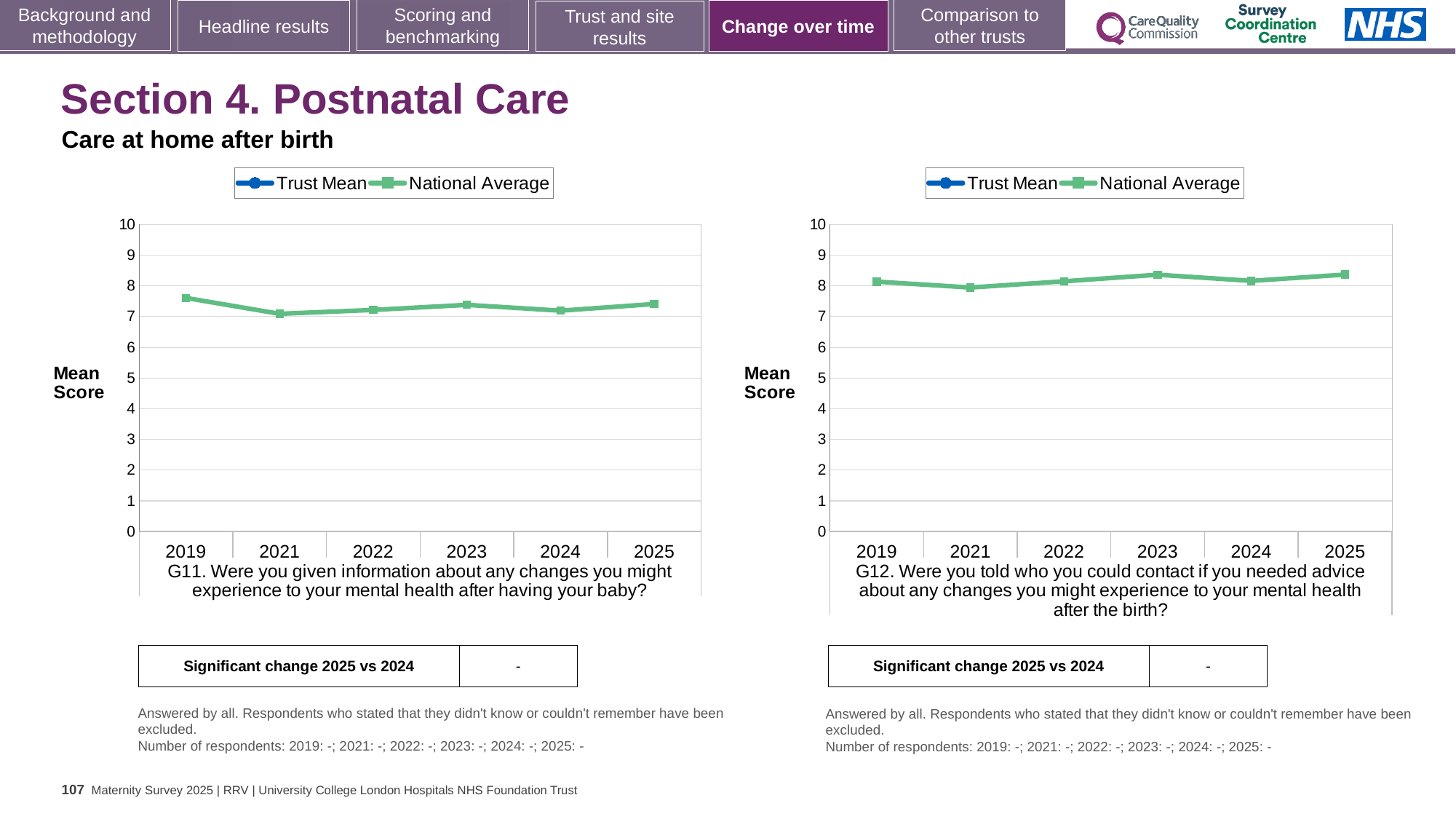
In the G12 chart on the right, is the National Average value larger in 2021 or in 2023? 2023 In the G11 chart on the left, which year has the highest National Average value? 2019 In the G12 chart on the right, which year has the lowest National Average value? 2021 What is the label of the y axis on the G11 chart on the left? Mean Score In the G11 chart on the left, is the National Average value larger in 2019 or in 2021? 2019 In the G11 chart on the left, is the National Average value for 2021 greater or less than 8? less In the G12 chart on the right, is the National Average value for 2023 greater or less than 8? greater What kind of chart is the G11 chart on the left? line chart How many years are shown on the x axis of the G11 chart on the left? 6 In the G11 chart on the left, is the National Average value for 2019 greater or less than 7? greater How many series does the legend of the G12 chart on the right list? 2